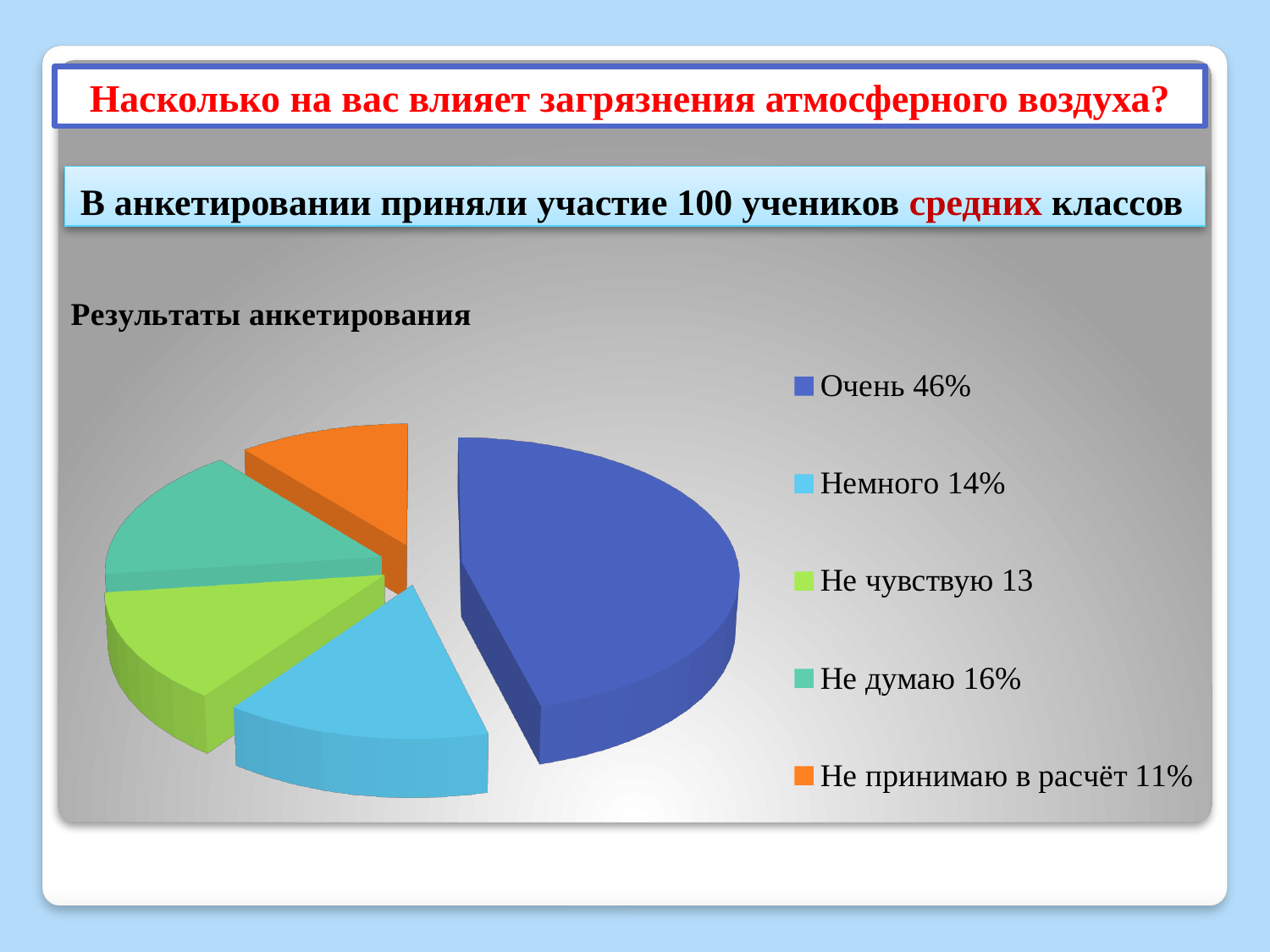
What kind of chart is shown on the slide? pie chart What share of respondents answered "Очень"? 46% Which colour is used for the "Не принимаю в расчёт" slice? orange How many slices does the pie chart have? 5 What share of respondents answered "Не принимаю в расчёт"? 11% What share of respondents answered "Немного"? 14% What share of respondents answered "Не думаю"? 16% What is the title of the chart? Результаты анкетирования Which answer has the smallest slice of the pie? Не принимаю в расчёт What is the difference between the share for "Очень" and the share for "Не принимаю в расчёт"? 35% Which answer has the largest slice of the pie? Очень Which is larger, the share for "Не думаю" or the share for "Немного"? Не думаю